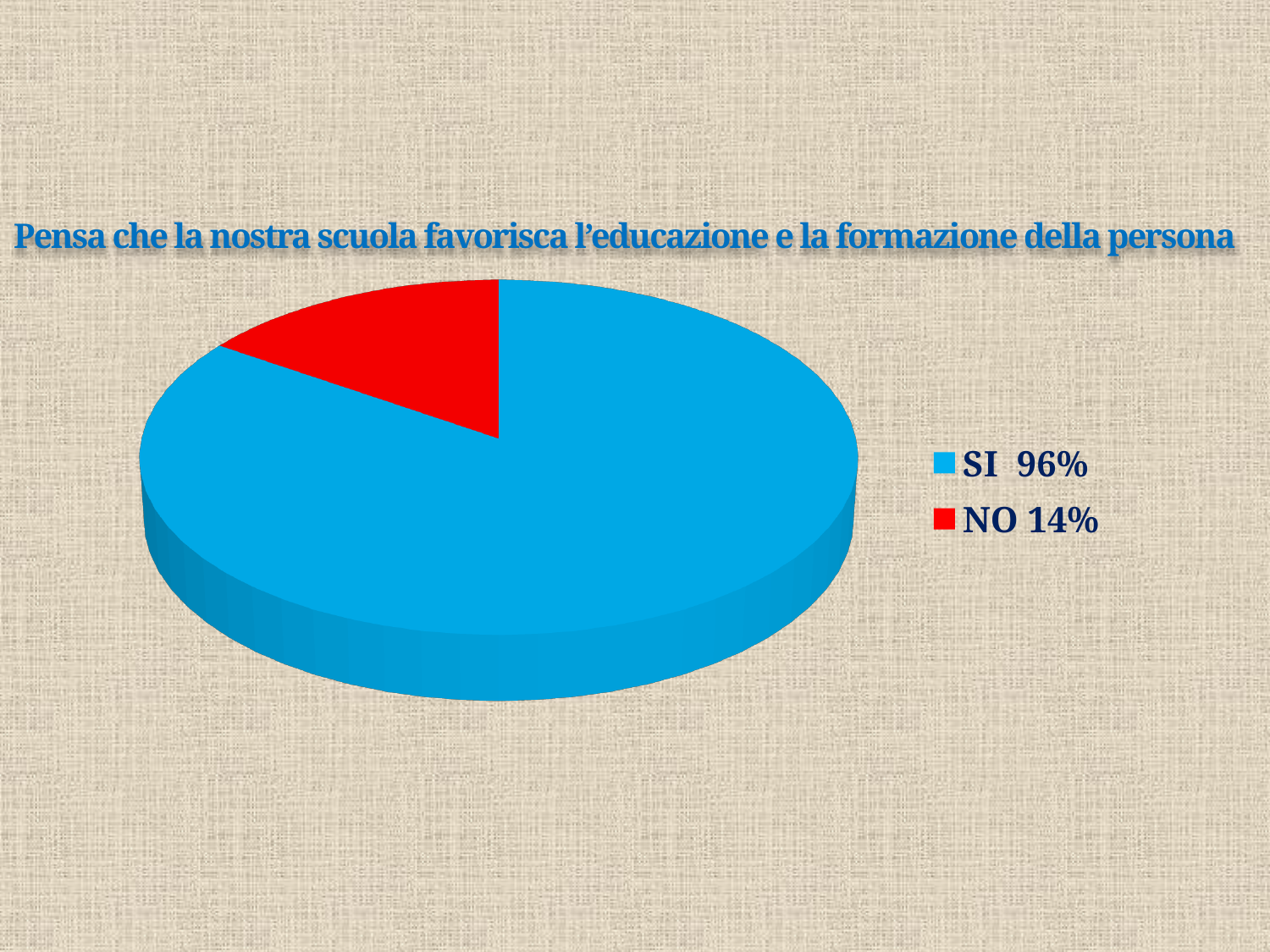
What share of the pie is labelled for SI? 96% Which is larger, the slice for SI or the slice for NO? SI What percentage is shown for NO in the legend? 14% How many entries does the legend list? 2 What is the difference between the percentages shown for SI and NO? 82% What is the title of the chart? Pensa che la nostra scuola favorisca l'educazione e la formazione della persona Which category has the smallest slice of the pie? NO What percentage is shown for SI in the legend? 96% How many slices does the pie chart have? 2 What colour is the slice for NO? red What kind of chart is shown on the slide? pie chart Which category has the largest slice of the pie? SI